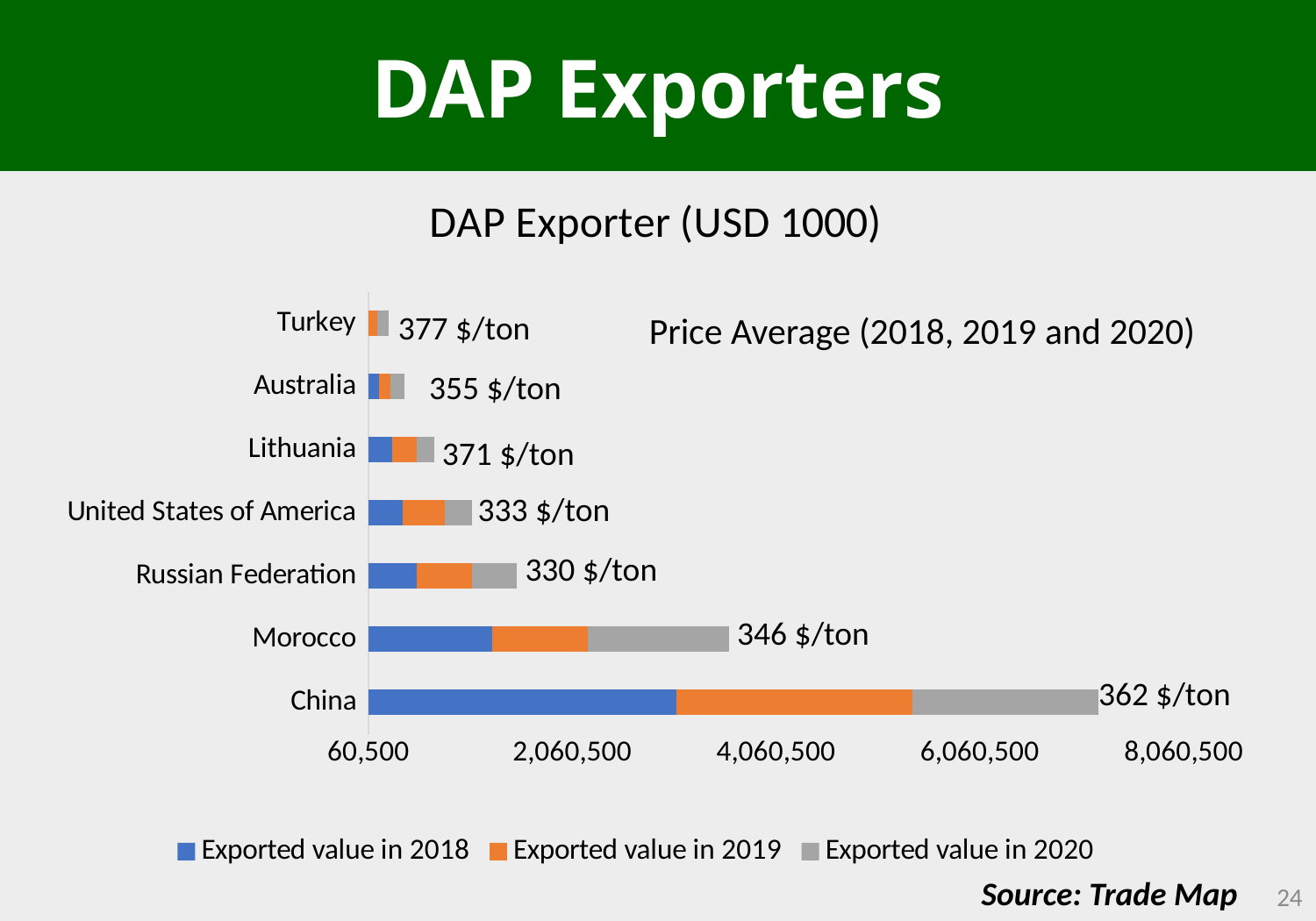
Which country has the shortest total bar? Turkey Which has the longer total bar, Morocco or the Russian Federation? Morocco Is the total exported value bar for China greater or less than 6,060,500? greater Which country has the lowest price average label on the chart? Russian Federation Is the total exported value bar for Morocco greater or less than 4,060,500? less How many countries are listed on the chart? 7 How many series does the legend list? 3 What price average is shown next to the bar for Morocco? 346 $/ton What is the title of the chart? DAP Exporter (USD 1000) What price average is shown next to the bar for Turkey? 377 $/ton Which country has the longest total bar? China What kind of chart is shown on the slide? Bar chart